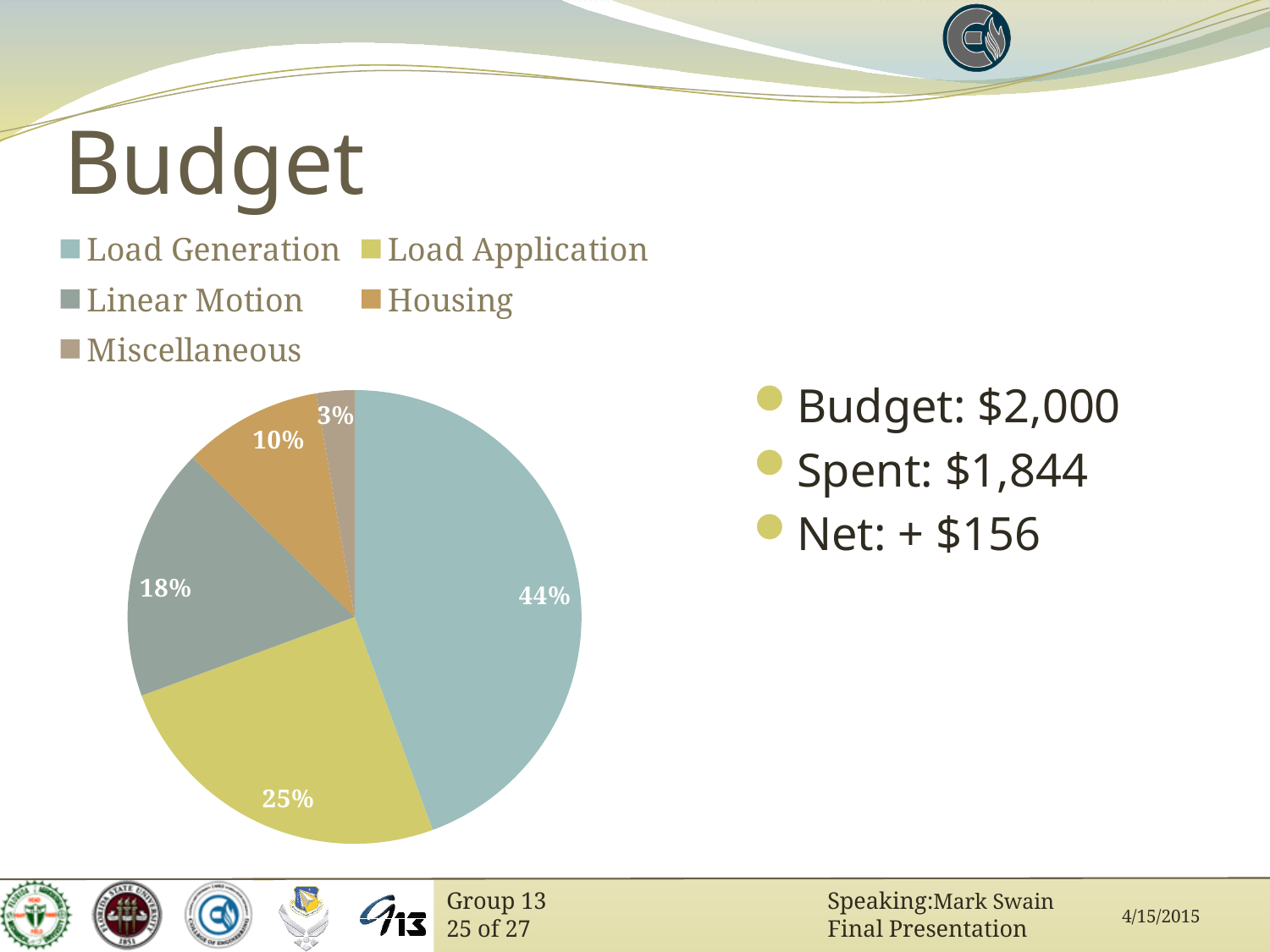
Which is larger, the Linear Motion slice or the Housing slice? Linear Motion What share of the pie does Housing represent? 10% How many categories are shown in the pie chart? 5 What type of chart is shown on the slide? Pie chart What share of the pie does Miscellaneous represent? 3% What is the difference in percentage points between Load Generation and Load Application? 19 What share of the pie does Load Generation represent? 44% What share of the pie does Linear Motion represent? 18% Which category has the largest slice of the pie? Load Generation Which category has the smallest slice of the pie? Miscellaneous What is the title of the slide containing the chart? Budget What share of the pie does Load Application represent? 25%